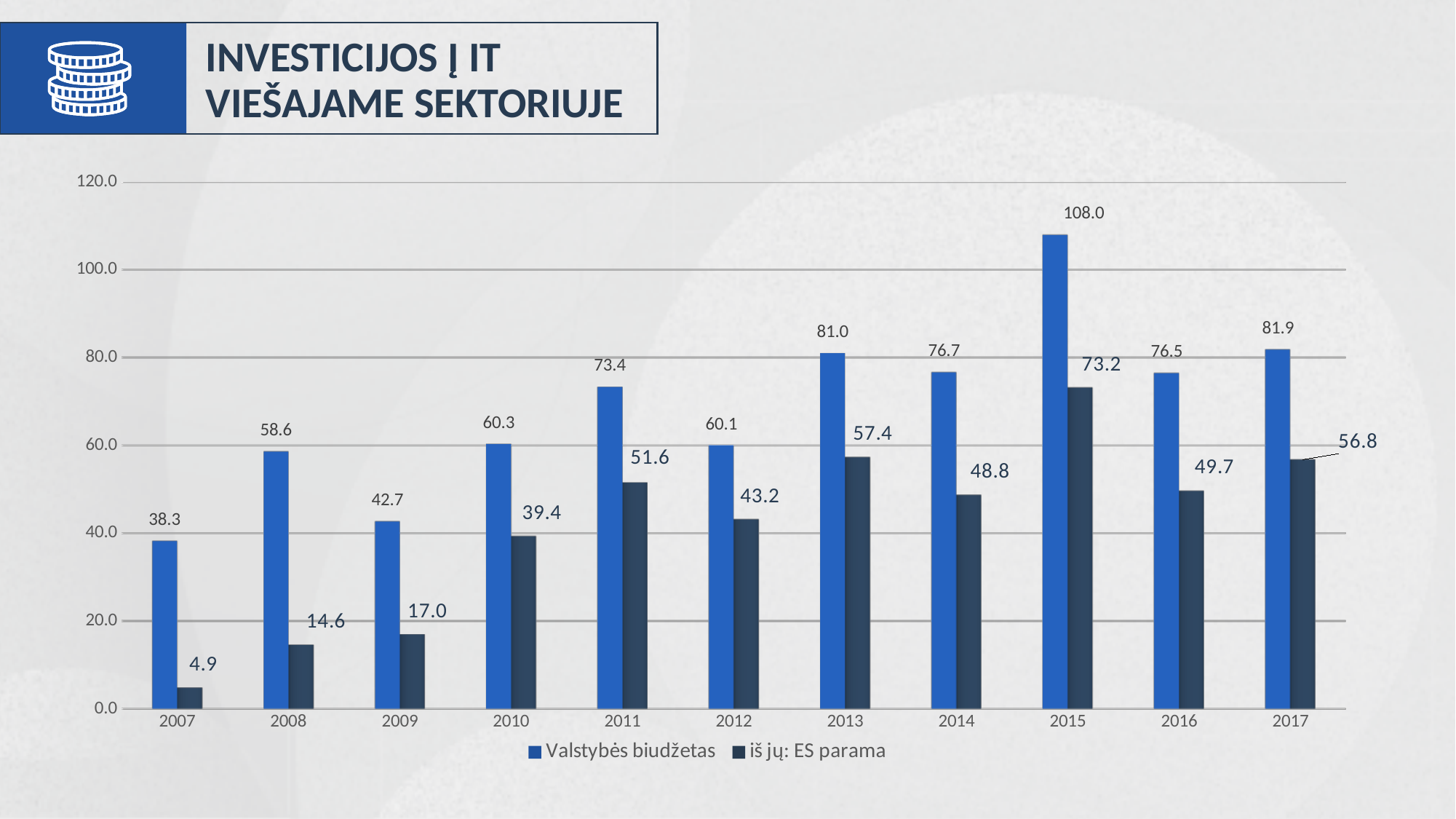
What is the difference between Valstybės biudžetas and iš jų: ES parama in 2015? 34.8 What is the value of Valstybės biudžetas for 2015? 108.0 What is the value of iš jų: ES parama for 2007? 4.9 Which year has the lowest iš jų: ES parama value? 2007 What is the value of iš jų: ES parama for 2017? 56.8 How many years are shown on the x axis? 11 Which year has the highest Valstybės biudžetas value? 2015 What is the title of the slide? INVESTICIJOS Į IT VIEŠAJAME SEKTORIUJE Does the iš jų: ES parama value rise or fall from 2007 to 2011? Rise Which is larger: Valstybės biudžetas in 2013 or in 2014? 2013 What kind of chart is shown on the slide? Bar chart How many series does the legend list? 2